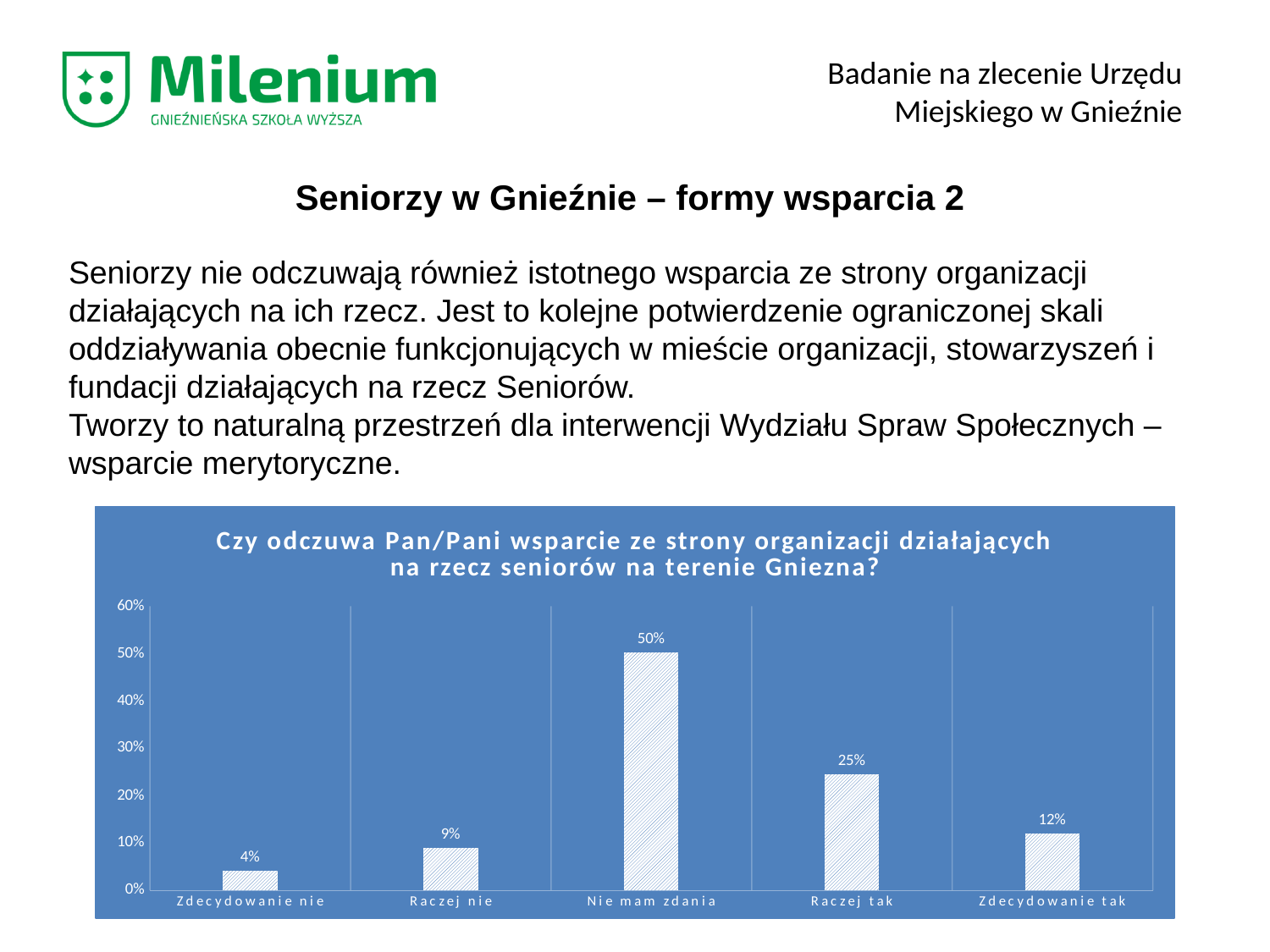
What is the value for "Raczej tak"? 25% Which category has the highest value? Nie mam zdania What is the value for "Nie mam zdania"? 50% What is the title of the chart? Czy odczuwa Pan/Pani wsparcie ze strony organizacji działających na rzecz seniorów na terenie Gniezna? What kind of chart is shown on the slide? bar chart Which is larger, the value for "Raczej nie" or the value for "Zdecydowanie tak"? Zdecydowanie tak How many categories are shown on the x axis? 5 Which category has the lowest value? Zdecydowanie nie What is the value for "Zdecydowanie tak"? 12% Is the value for "Raczej tak" greater or less than 20%? greater What is the value for "Zdecydowanie nie"? 4% What is the difference between the values for "Nie mam zdania" and "Raczej tak"? 25%